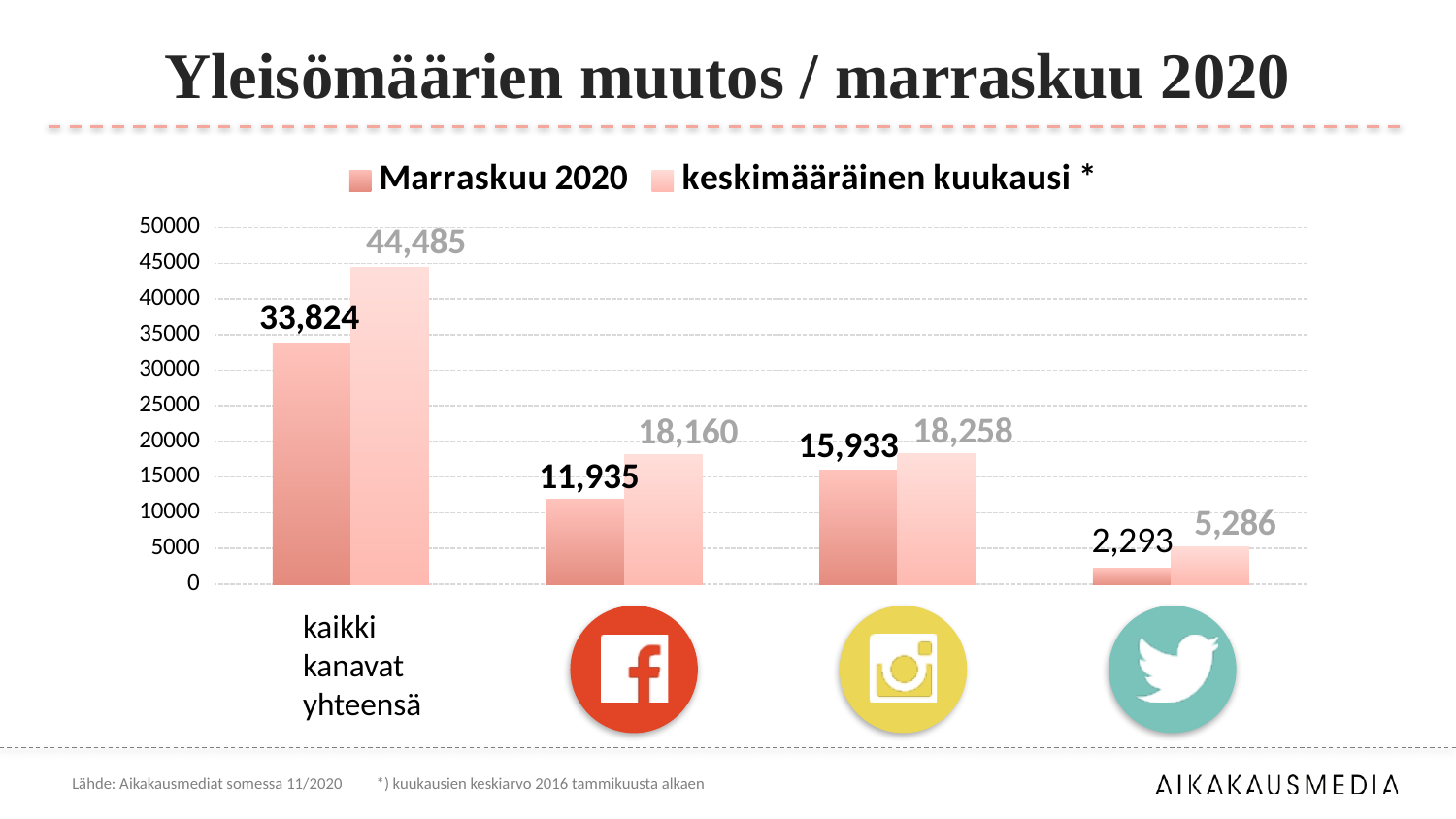
What is the Marraskuu 2020 value for the Facebook category? 11,935 What is the difference between the keskimääräinen kuukausi and Marraskuu 2020 values for the Twitter category? 2,993 What is the value for keskimääräinen kuukausi in the 'kaikki kanavat yhteensä' category? 44,485 How many series does the legend list? 2 Which is larger for the Instagram category: the Marraskuu 2020 value or the keskimääräinen kuukausi value? keskimääräinen kuukausi What is the keskimääräinen kuukausi value for the Instagram category? 18,258 What is the value for Marraskuu 2020 in the 'kaikki kanavat yhteensä' category? 33,824 What kind of chart is shown on the slide? Bar chart How many categories are shown on the x axis? 4 Which category has the lowest Marraskuu 2020 value? Twitter Which category has the highest keskimääräinen kuukausi value? kaikki kanavat yhteensä What is the Marraskuu 2020 value for the Twitter category? 2,293